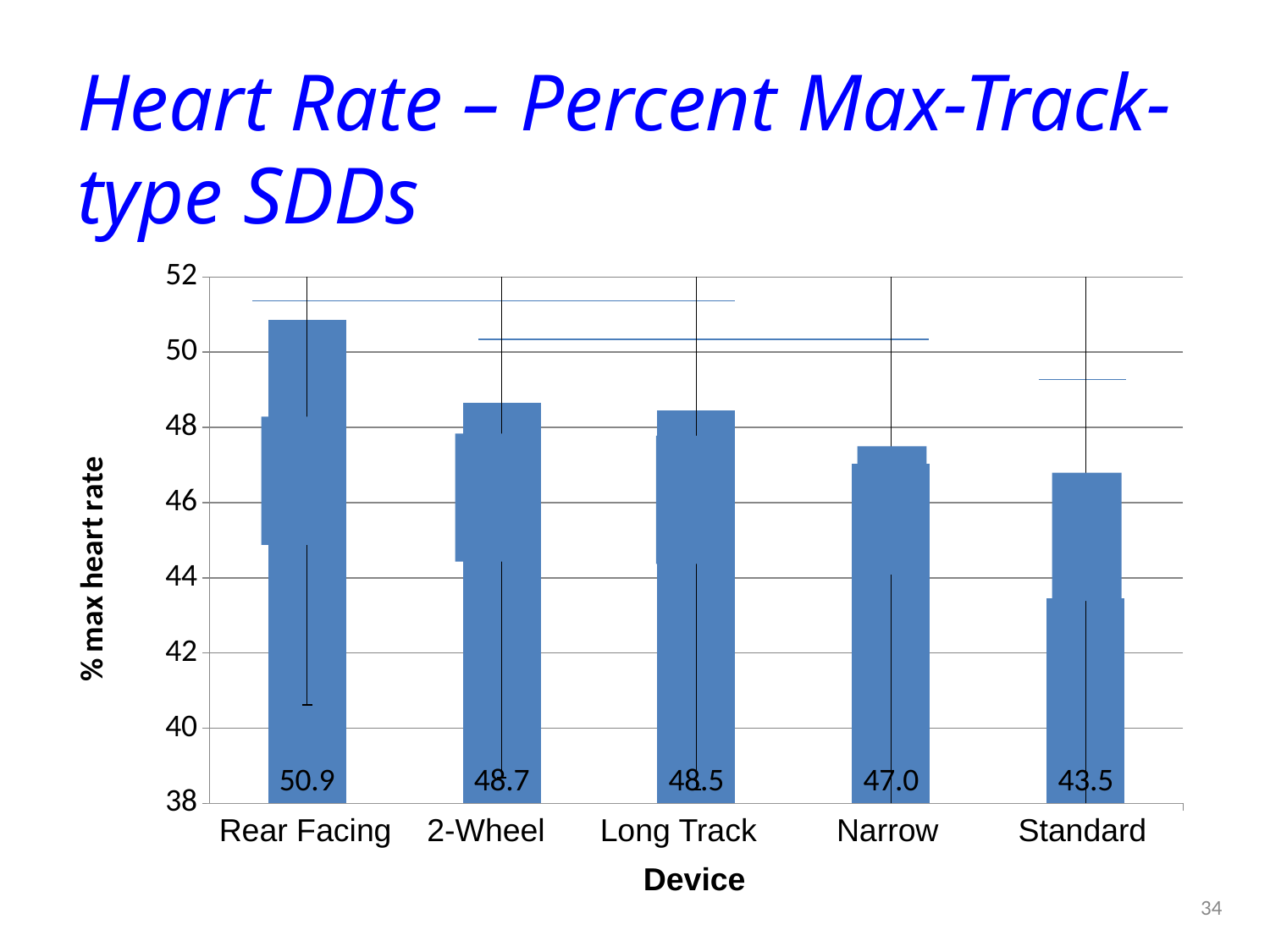
Is the value for Narrow greater or less than 48? less What is the value for Rear Facing? 50.9 Which device has the highest % max heart rate? Rear Facing What is the value for Standard? 43.5 Which is larger, the value for Long Track or the value for Narrow? Long Track Which device has the lowest % max heart rate? Standard What kind of chart is shown on the slide? bar chart What is the difference between the values for 2-Wheel and Narrow? 1.7 What is the difference between the values for Rear Facing and Standard? 7.4 How many devices are shown on the x axis? 5 What is the label of the y axis? % max heart rate What is the value for Narrow? 47.0